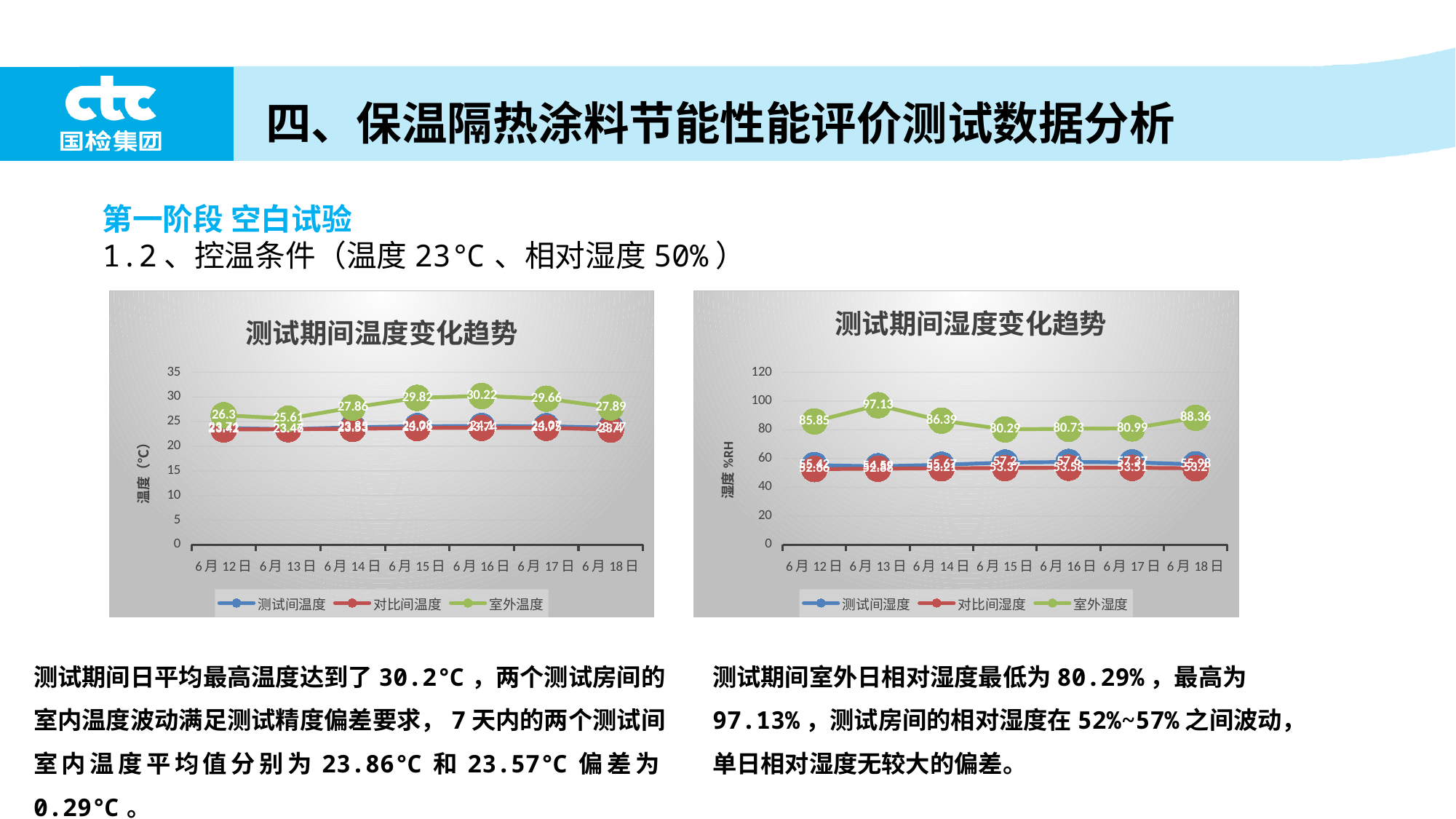
In the chart titled 测试期间湿度变化趋势, which is larger, the 室外湿度 value on 6月12日 or on 6月18日? 6月18日 In the chart titled 测试期间湿度变化趋势, on which date is 室外湿度 lowest? 6月15日 In the chart titled 测试期间温度变化趋势, on which date is 室外温度 highest? 6月16日 In the chart titled 测试期间湿度变化趋势, how many dates are shown on the x axis? 7 In the chart titled 测试期间温度变化趋势, on which date is 室外温度 lowest? 6月13日 In the chart titled 测试期间湿度变化趋势, what is the value of 室外湿度 on 6月13日? 97.13 In the chart titled 测试期间温度变化趋势, what is the difference between the 室外温度 values on 6月16日 and 6月13日? 4.61 In the chart titled 测试期间温度变化趋势, what is the value of 室外温度 on 6月13日? 25.61 In the chart titled 测试期间湿度变化趋势, is the value of 室外湿度 on 6月13日 greater or less than 80? greater In the chart titled 测试期间温度变化趋势, what is the value of 室外温度 on 6月16日? 30.22 In the chart titled 测试期间温度变化趋势, how many series does the legend list? 3 What kind of chart is the chart titled 测试期间湿度变化趋势? line chart